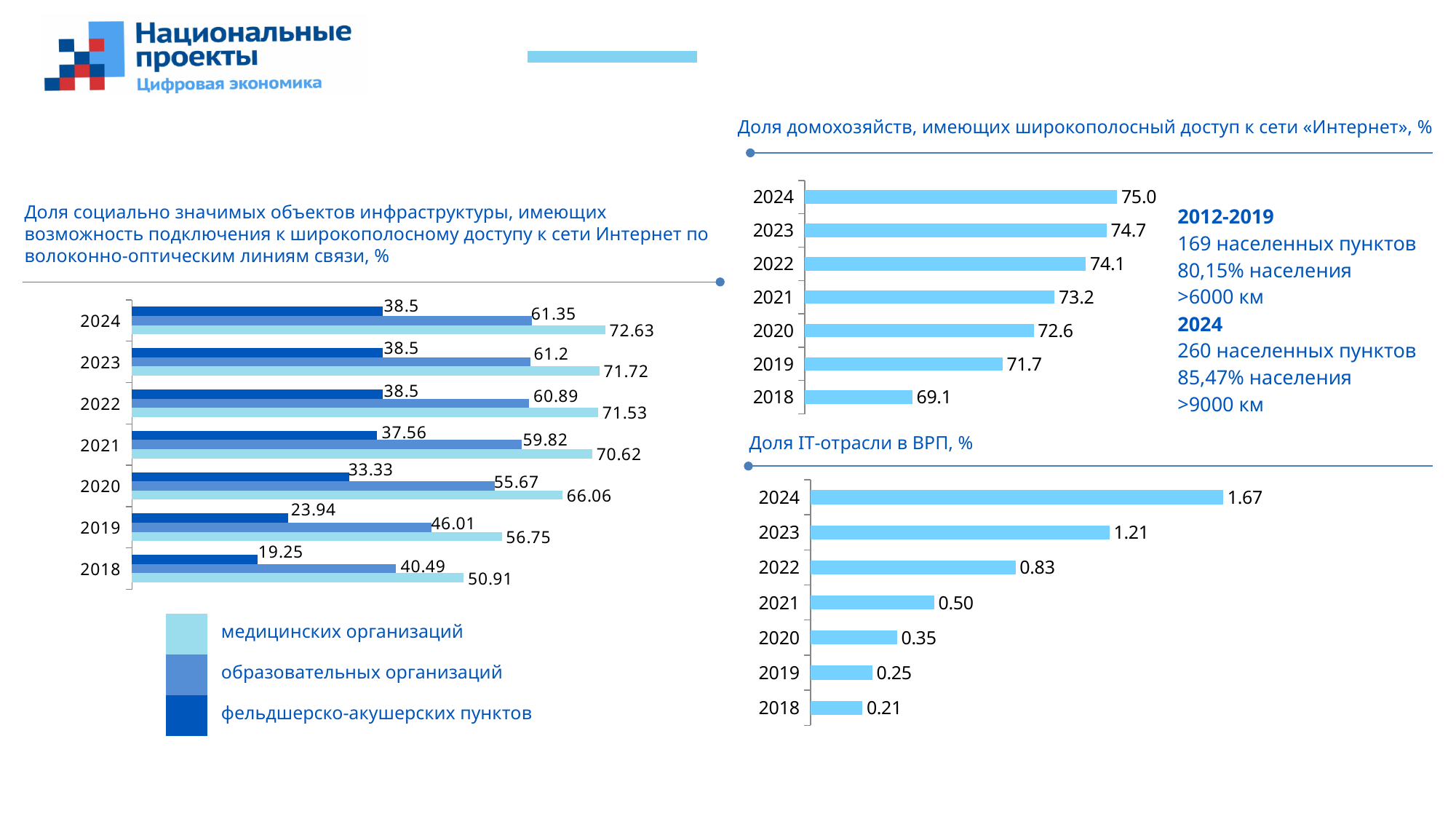
How many years are shown in the chart 'Доля IT-отрасли в ВРП, %'? 7 In the left chart 'Доля социально значимых объектов инфраструктуры...', what is the value for фельдшерско-акушерских пунктов in 2018? 19.25 In the chart 'Доля домохозяйств, имеющих широкополосный доступ к сети «Интернет», %', which year has the highest value? 2024 In the chart 'Доля домохозяйств, имеющих широкополосный доступ к сети «Интернет», %', what is the value for 2024? 75.0 In the left chart 'Доля социально значимых объектов инфраструктуры...', what is the value for медицинских организаций in 2020? 66.06 In the left chart 'Доля социально значимых объектов инфраструктуры...', which is larger in 2019: образовательных организаций or фельдшерско-акушерских пунктов? образовательных организаций In the chart 'Доля IT-отрасли в ВРП, %', which year has the lowest value? 2018 In the chart 'Доля IT-отрасли в ВРП, %', what is the difference between the 2024 and 2023 values? 0.46 In the chart 'Доля IT-отрасли в ВРП, %', do the values rise or fall from 2018 to 2024? rise In the chart 'Доля домохозяйств, имеющих широкополосный доступ к сети «Интернет», %', what is the difference between the 2024 and 2018 values? 5.9 How many series does the legend of the left chart 'Доля социально значимых объектов инфраструктуры...' list? 3 In the chart 'Доля IT-отрасли в ВРП, %', what is the value for 2022? 0.83